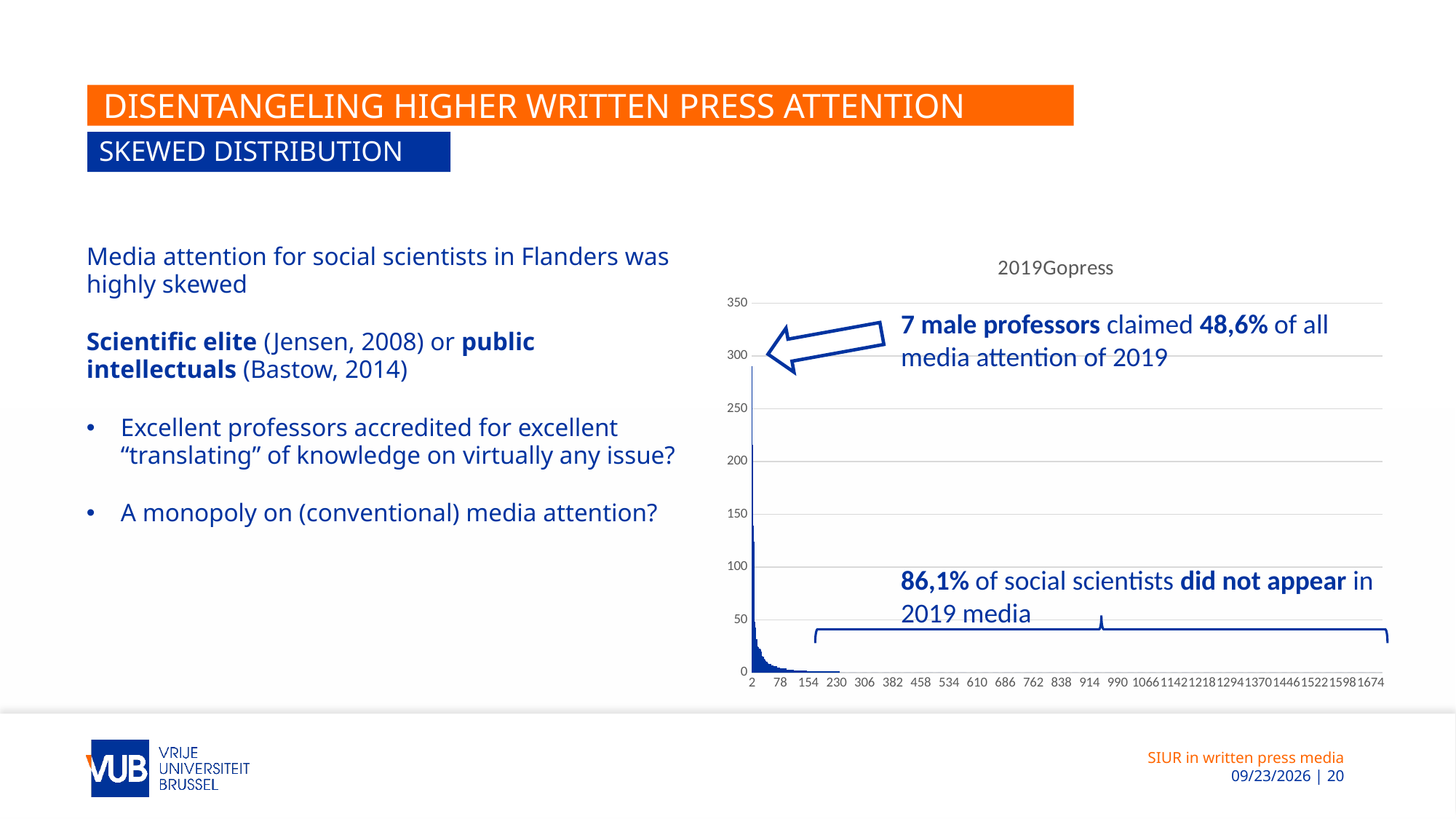
What is the title of the chart? 2019Gopress Do the values rise or fall along the x axis of the chart? fall Is the value of the tallest bar in the chart greater or less than 250? greater What kind of chart is shown on the slide? bar chart According to the annotation on the chart, what percentage of social scientists did not appear in 2019 media? 86,1% According to the annotation on the chart, what share of all media attention of 2019 did 7 male professors claim? 48,6% Is the value of the tallest bar in the chart greater or less than 350? less What is the highest value shown on the chart's y axis? 350 What is the last tick label on the chart's x axis? 1674 What is the first tick label on the chart's x axis? 2 According to the chart annotation, how many male professors claimed 48,6% of all media attention of 2019? 7